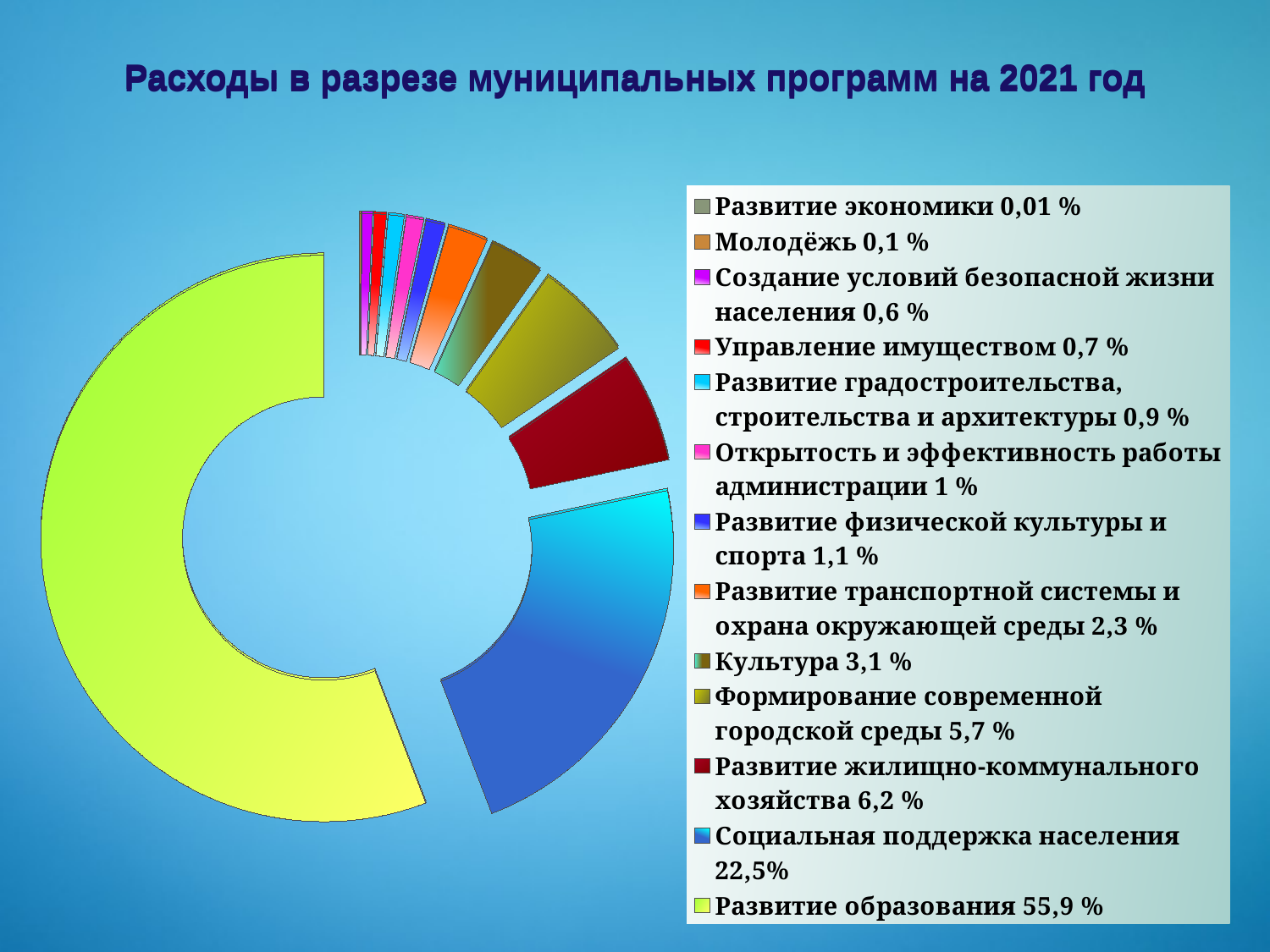
What share is shown for Развитие жилищно-коммунального хозяйства? 6,2 % What share is shown for Культура? 3,1 % What type of chart is shown on the slide? Doughnut (pie) chart What share is shown for Социальная поддержка населения? 22,5% What share is shown for Развитие транспортной системы и охрана окружающей среды? 2,3 % What is the difference in percentage points between Развитие образования and Социальная поддержка населения? 33,4 % What share is shown for Развитие образования? 55,9 % Which is larger: Формирование современной городской среды or Развитие жилищно-коммунального хозяйства? Развитие жилищно-коммунального хозяйства How many categories does the legend list? 13 Which category has the largest share? Развитие образования Which category has the smallest share? Развитие экономики What is the title of the chart? Расходы в разрезе муниципальных программ на 2021 год